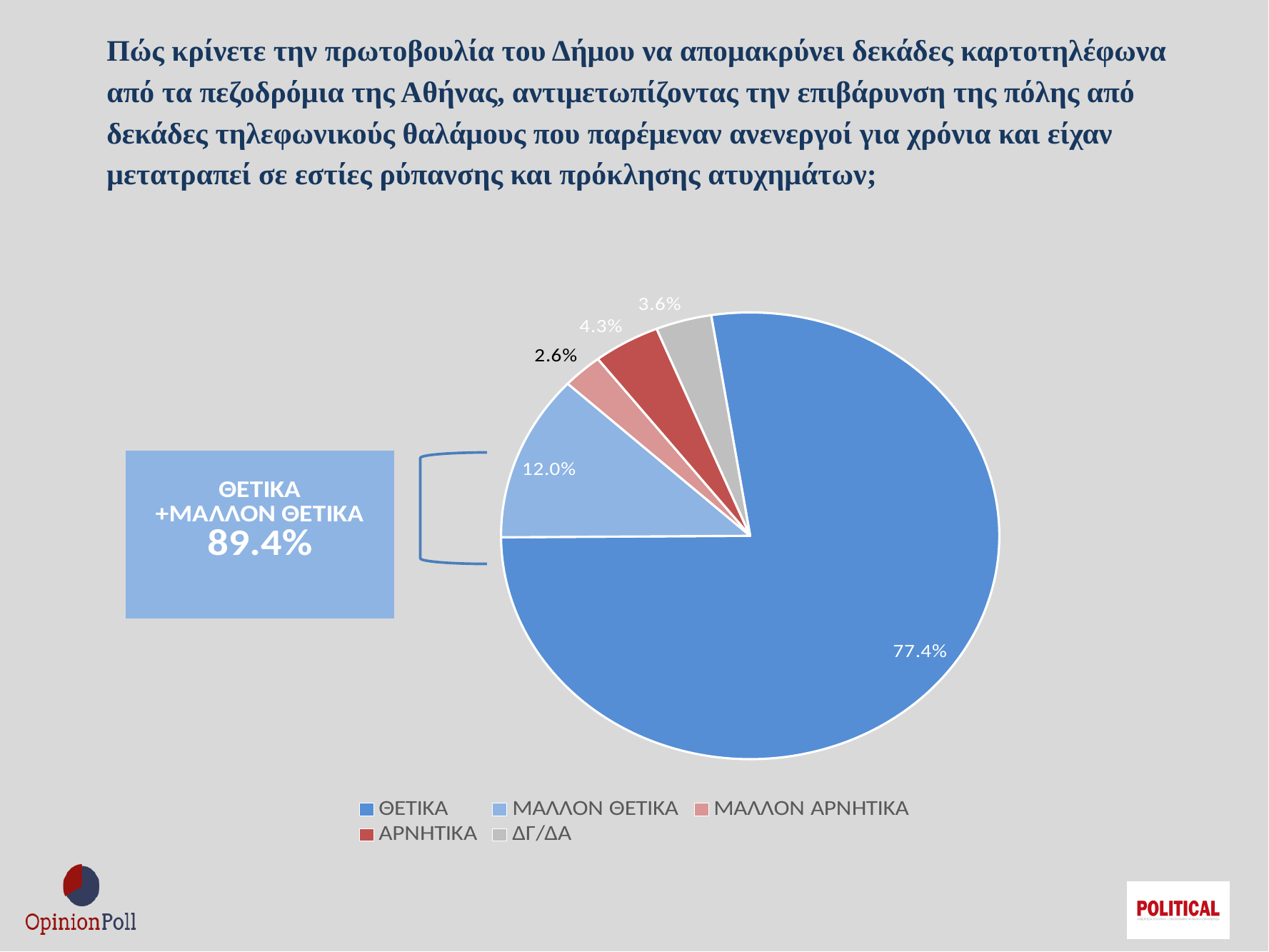
Which response category has the smallest share of the pie? ΜΑΛΛΟΝ ΑΡΝΗΤΙΚΑ What percentage of respondents answered ΜΑΛΛΟΝ ΘΕΤΙΚΑ? 12.0% Which response category has the largest share of the pie? ΘΕΤΙΚΑ Which is larger, the share for ΑΡΝΗΤΙΚΑ or the share for ΔΓ/ΔΑ? ΑΡΝΗΤΙΚΑ What type of chart is shown on the slide? pie chart What is the difference in percentage points between ΘΕΤΙΚΑ and ΜΑΛΛΟΝ ΘΕΤΙΚΑ? 65.4 What percentage of respondents answered ΑΡΝΗΤΙΚΑ? 4.3% How many categories does the legend of the pie chart list? 5 What percentage of respondents answered ΜΑΛΛΟΝ ΑΡΝΗΤΙΚΑ? 2.6% What percentage of respondents answered ΔΓ/ΔΑ? 3.6% What percentage of respondents answered ΘΕΤΙΚΑ? 77.4% What combined percentage does the callout box give for ΘΕΤΙΚΑ + ΜΑΛΛΟΝ ΘΕΤΙΚΑ? 89.4%